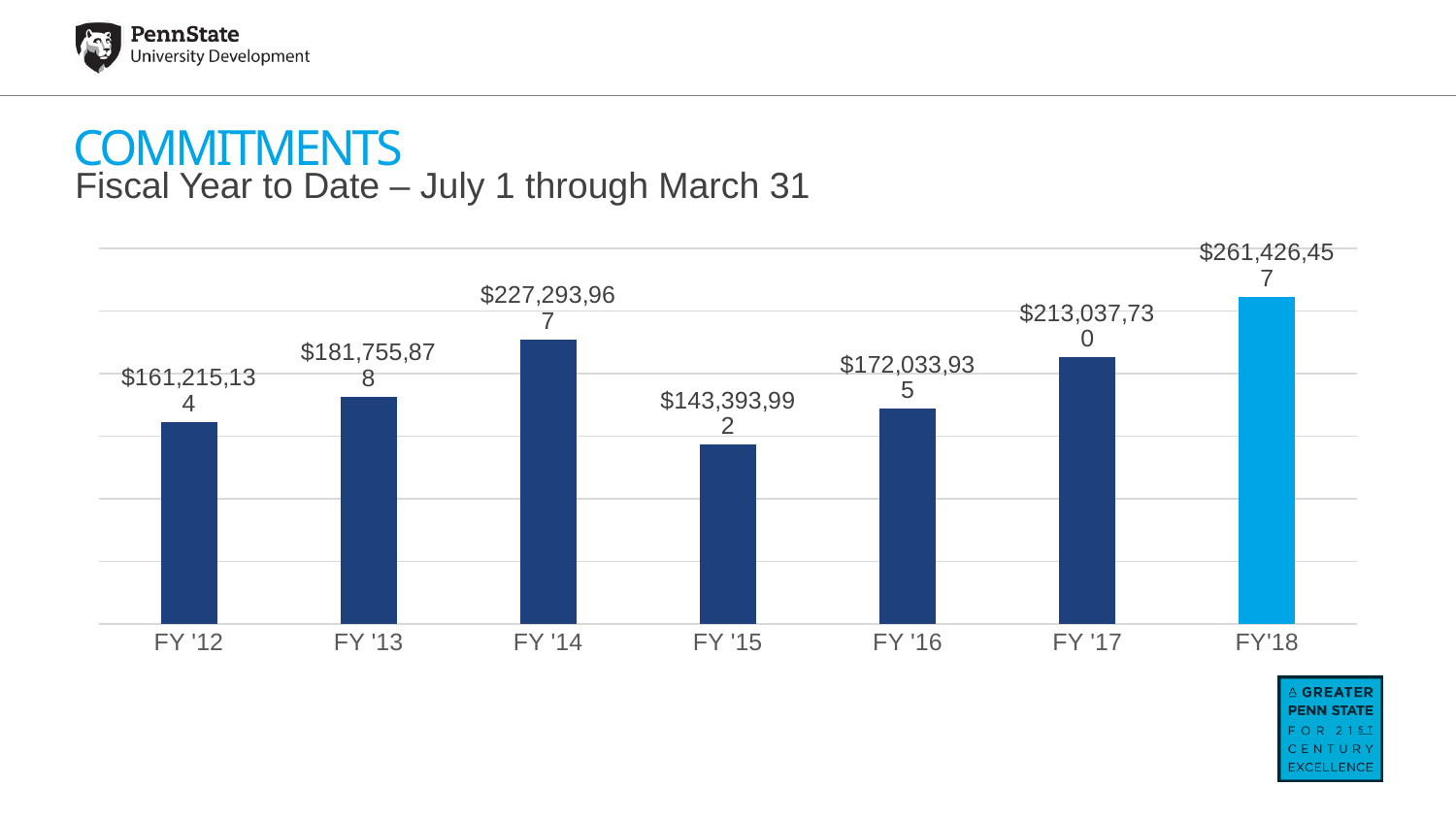
Which fiscal year has the lowest value? FY '15 How many fiscal years are shown on the chart? 7 Which is larger, the value for FY '16 or the value for FY '13? FY '13 What is the value for FY '12? $161,215,134 What kind of chart is shown on the slide? Bar chart What is the value for FY '17? $213,037,730 Which fiscal year has the highest value? FY'18 Which bar is shown in a lighter blue colour than the others? FY'18 Does the value rise or fall from FY '14 to FY '15? Fall What is the value for FY '15? $143,393,992 What is the difference between the FY '14 and FY '13 values? $45,538,089 What is the difference between the FY'18 and FY '17 values? $48,388,727